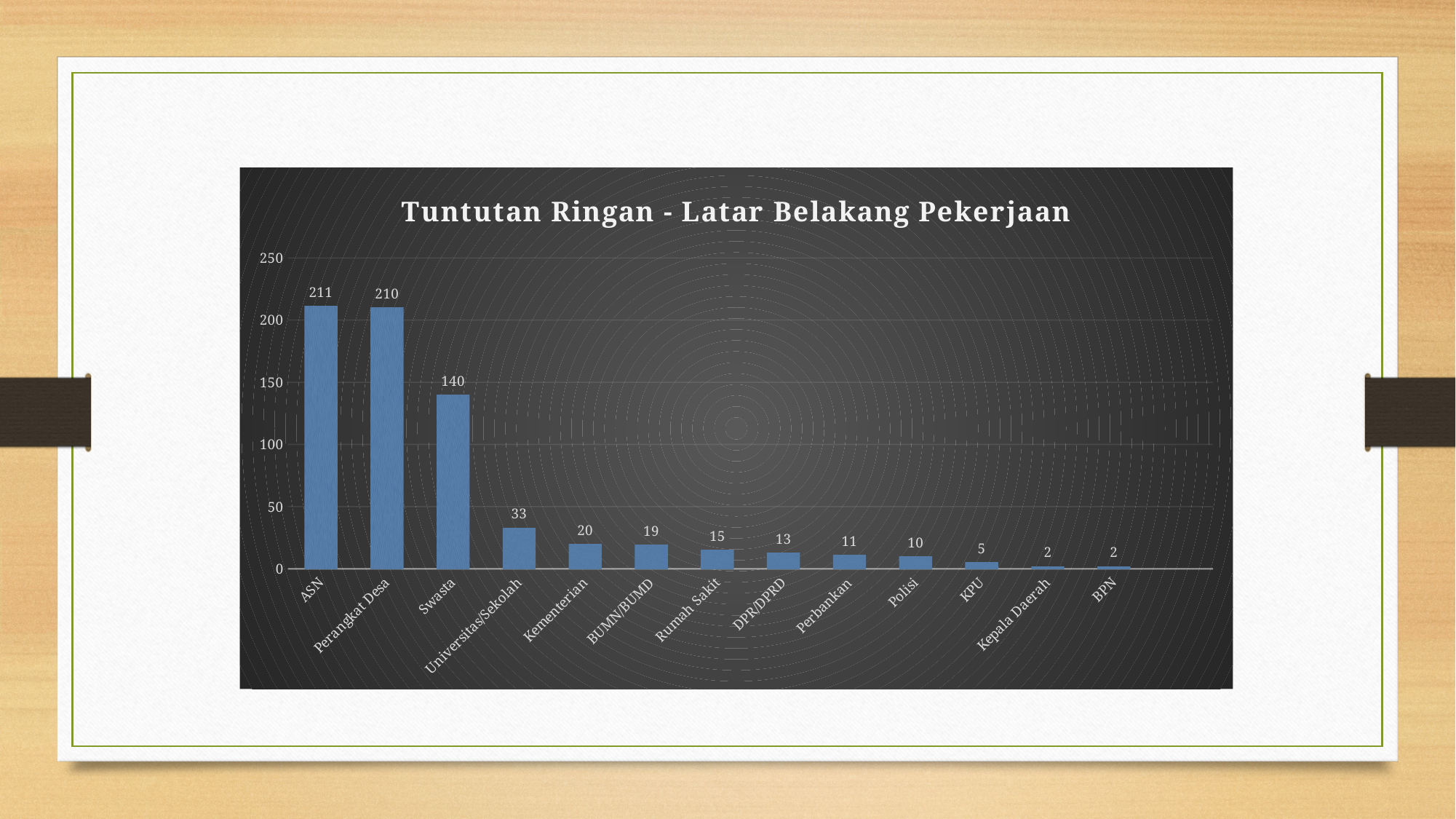
What is the value for Swasta? 140 Is the value for Swasta greater or less than 100? greater What is the value for KPU? 5 What kind of chart is shown on the slide? bar chart Which category has the highest value? ASN What is the value for Perangkat Desa? 210 What is the difference between the values for Kementerian and BUMN/BUMD? 1 Do the values rise or fall from left to right along the x axis? fall Which is larger, the value for Rumah Sakit or the value for Polisi? Rumah Sakit What is the value for Universitas/Sekolah? 33 How many categories are shown on the x axis? 13 What is the difference between the values for ASN and Swasta? 71